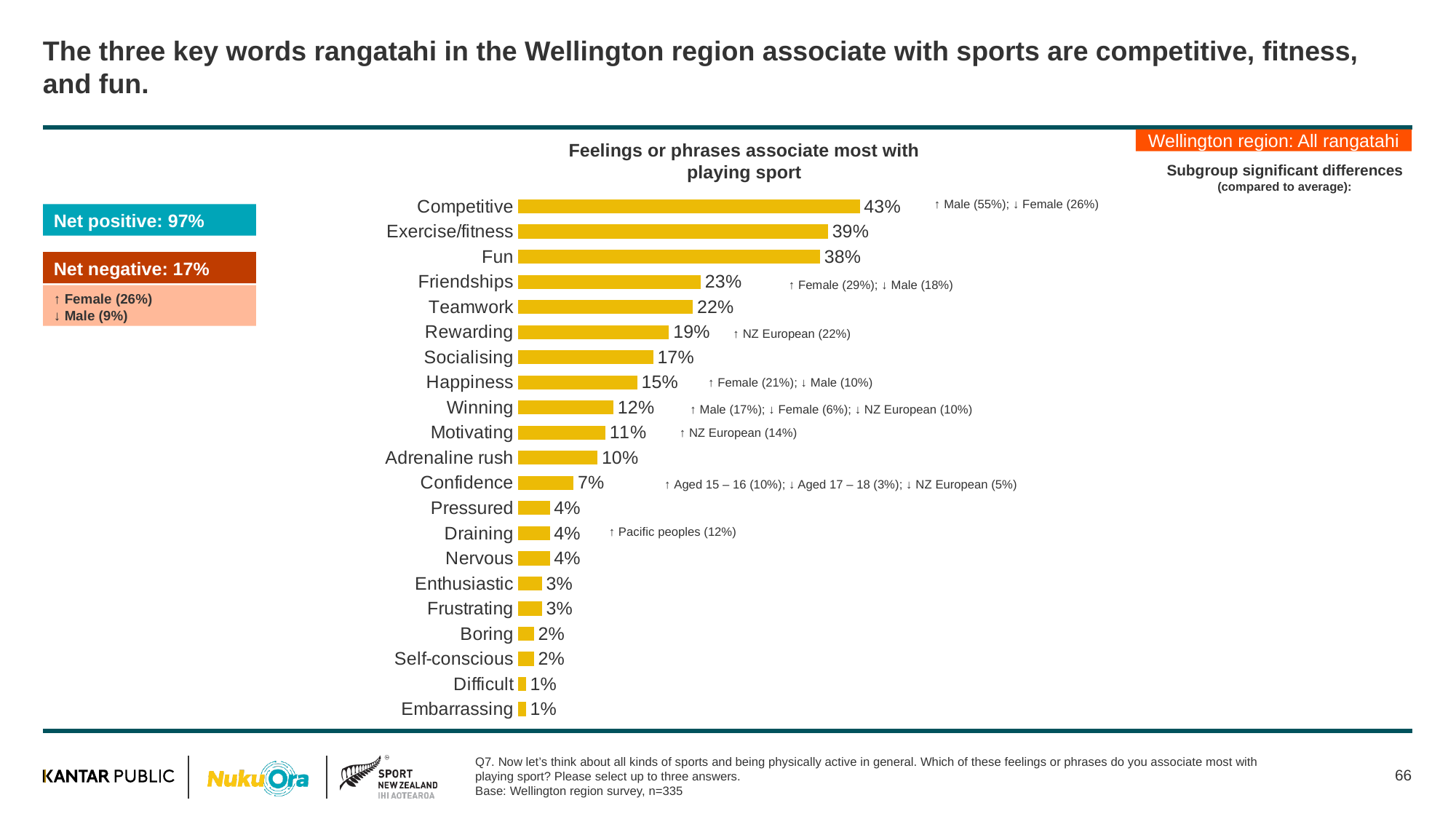
Which has a larger value, 'Rewarding' or 'Socialising'? Rewarding What is the difference between the values for 'Friendships' and 'Happiness'? 8% Which feeling or phrase has the highest percentage in the chart? Competitive What is the value shown for 'Adrenaline rush'? 10% Do the values rise or fall going from the top category to the bottom category of the chart? Fall What is the value shown for 'Teamwork'? 22% What is the difference between the values for 'Competitive' and 'Exercise/fitness'? 4% What is the title of the chart? Feelings or phrases associate most with playing sport Which has a larger value, 'Winning' or 'Confidence'? Winning How many feelings or phrases are listed in the chart? 21 What percentage of rangatahi associate 'Competitive' with playing sport? 43% What type of chart is used to show the feelings or phrases associated with playing sport? Bar chart